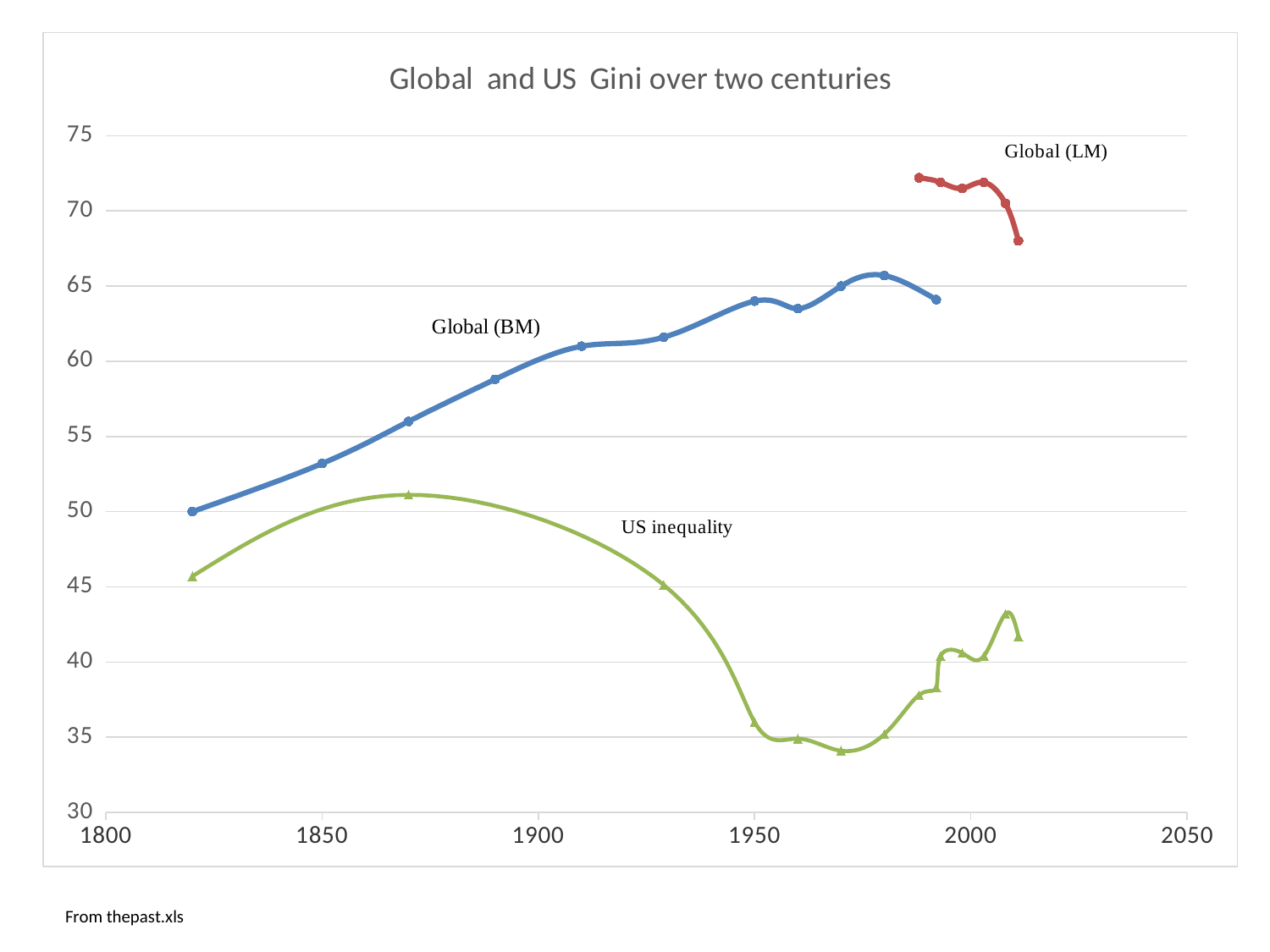
Which series has the lowest values on the chart? US inequality Is the value of Global (BM) in 1890 greater or less than 55? greater Does the US inequality series rise or fall between 1870 and 1970? fall Is the value of Global (BM) in 1850 greater or less than 55? less How many data series are plotted on the chart? 3 Is the value of US inequality in 1970 greater or less than 35? less What kind of chart is shown on the slide? line chart What is the title of the chart? Global and US Gini over two centuries Around 1990, which series is higher: Global (LM) or Global (BM)? Global (LM) Which series reaches the highest values on the chart? Global (LM)